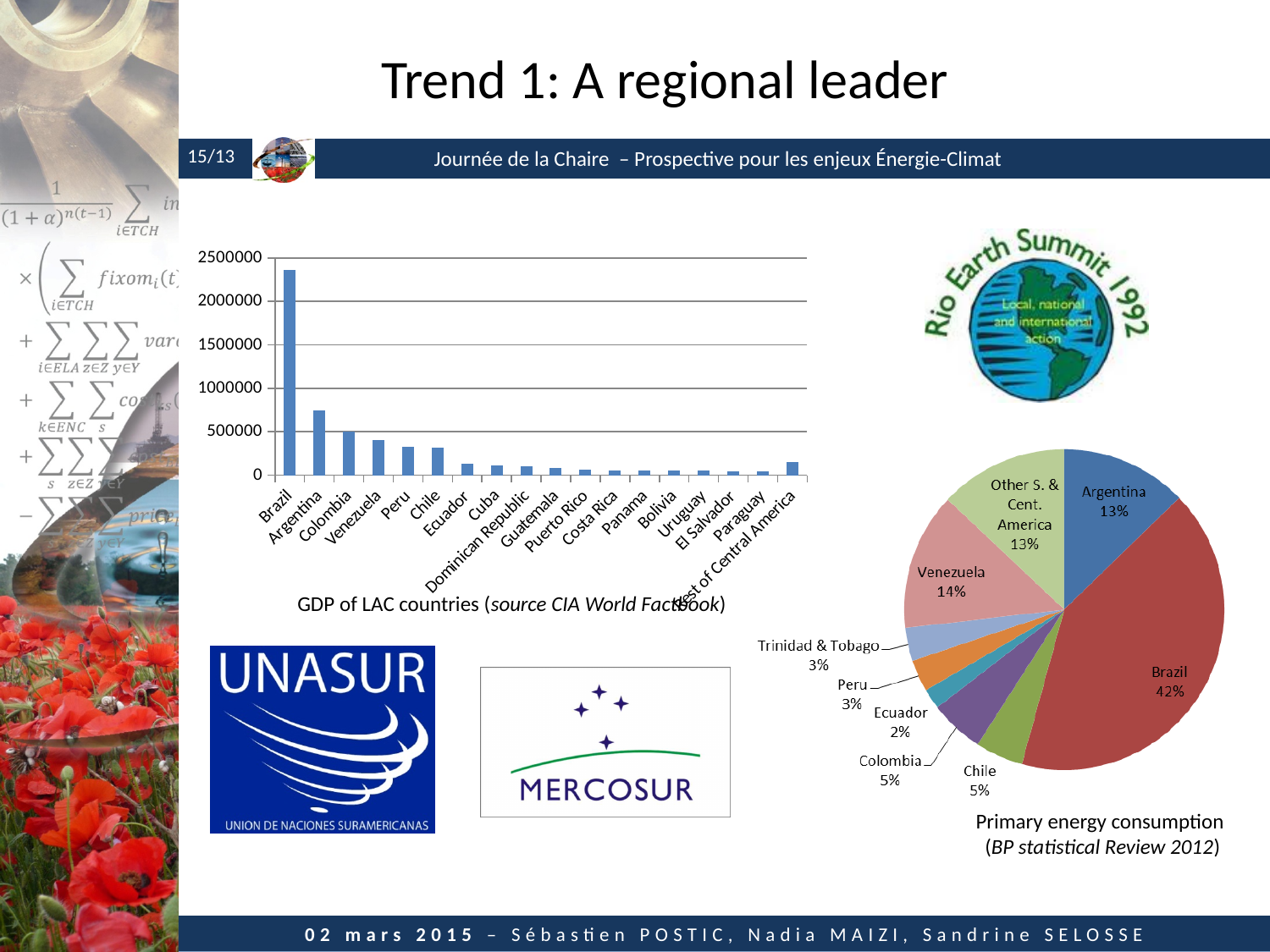
In the 'Primary energy consumption' pie chart, what share does Brazil have? 42% In the 'Primary energy consumption' pie chart, which country has the smallest share? Ecuador In the 'GDP of LAC countries' chart, which country has the highest GDP? Brazil In the 'Primary energy consumption' pie chart, what share does Venezuela have? 14% What kind of chart is the 'Primary energy consumption' chart? pie chart In the 'GDP of LAC countries' chart, is the value for Brazil greater or less than 2000000? greater In the 'GDP of LAC countries' chart, how many categories are shown on the x axis? 18 In the 'GDP of LAC countries' chart, is the value for Venezuela greater or less than 500000? less What kind of chart is the 'GDP of LAC countries' chart? bar chart In the 'Primary energy consumption' pie chart, how many slices are there? 9 In the 'GDP of LAC countries' chart, which is larger, the value for Argentina or the value for Peru? Argentina In the 'Primary energy consumption' pie chart, what is the difference between the shares of Brazil and Argentina? 29%